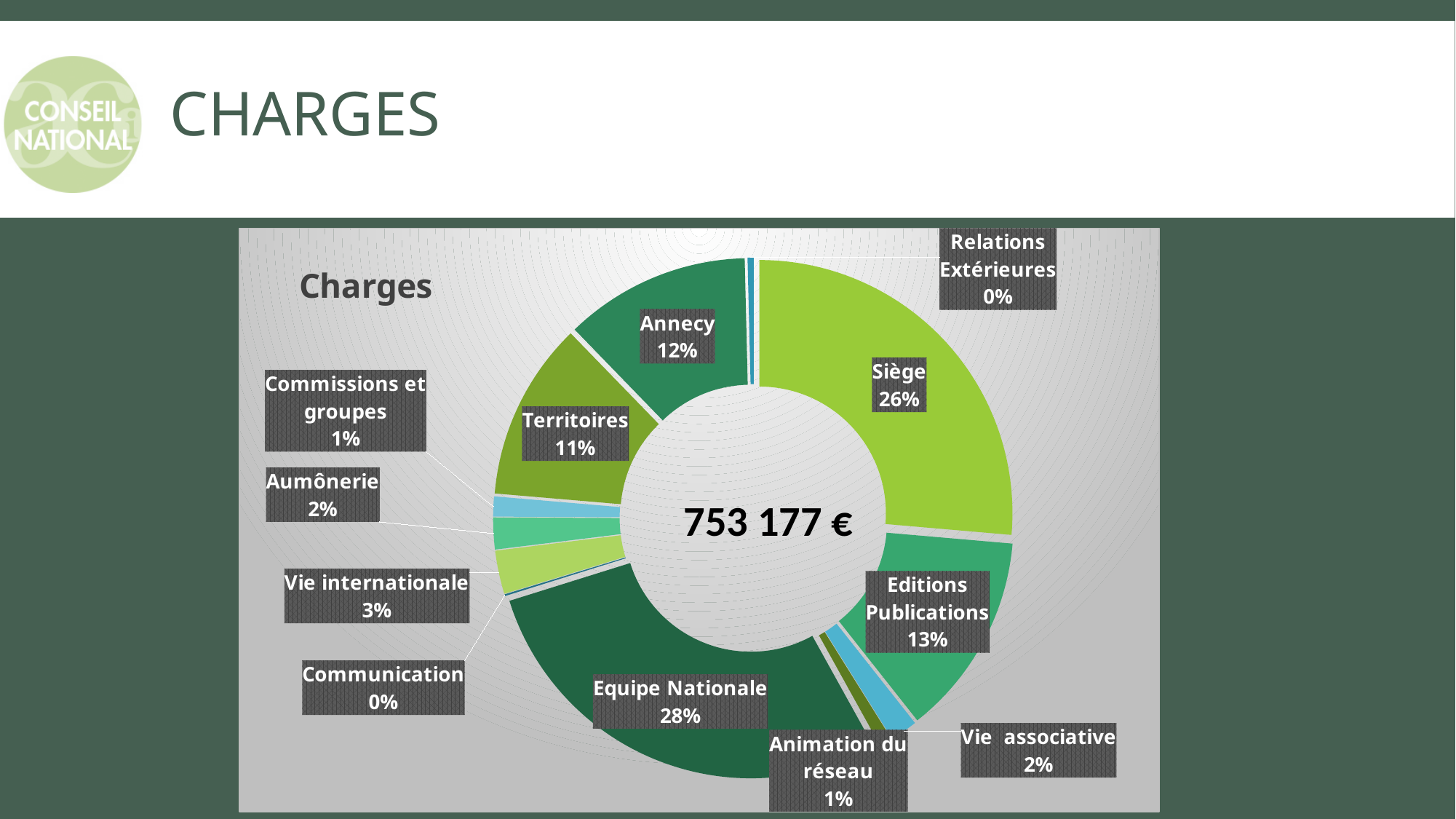
What is the difference in percentage points between Siège and Editions Publications? 13 Which category has the largest share of charges? Equipe Nationale What is the title of the chart? Charges What total amount is displayed in the centre of the doughnut? 753 177 € What percentage is shown for Territoires? 11% What percentage is shown for Vie internationale? 3% What kind of chart is shown on the slide? Doughnut (pie) chart What share of charges does Equipe Nationale represent? 28% Which is larger, the share for Annecy or the share for Territoires? Annecy How many categories are shown in the chart? 12 What percentage is shown for Editions Publications? 13% What share of charges does Siège represent? 26%